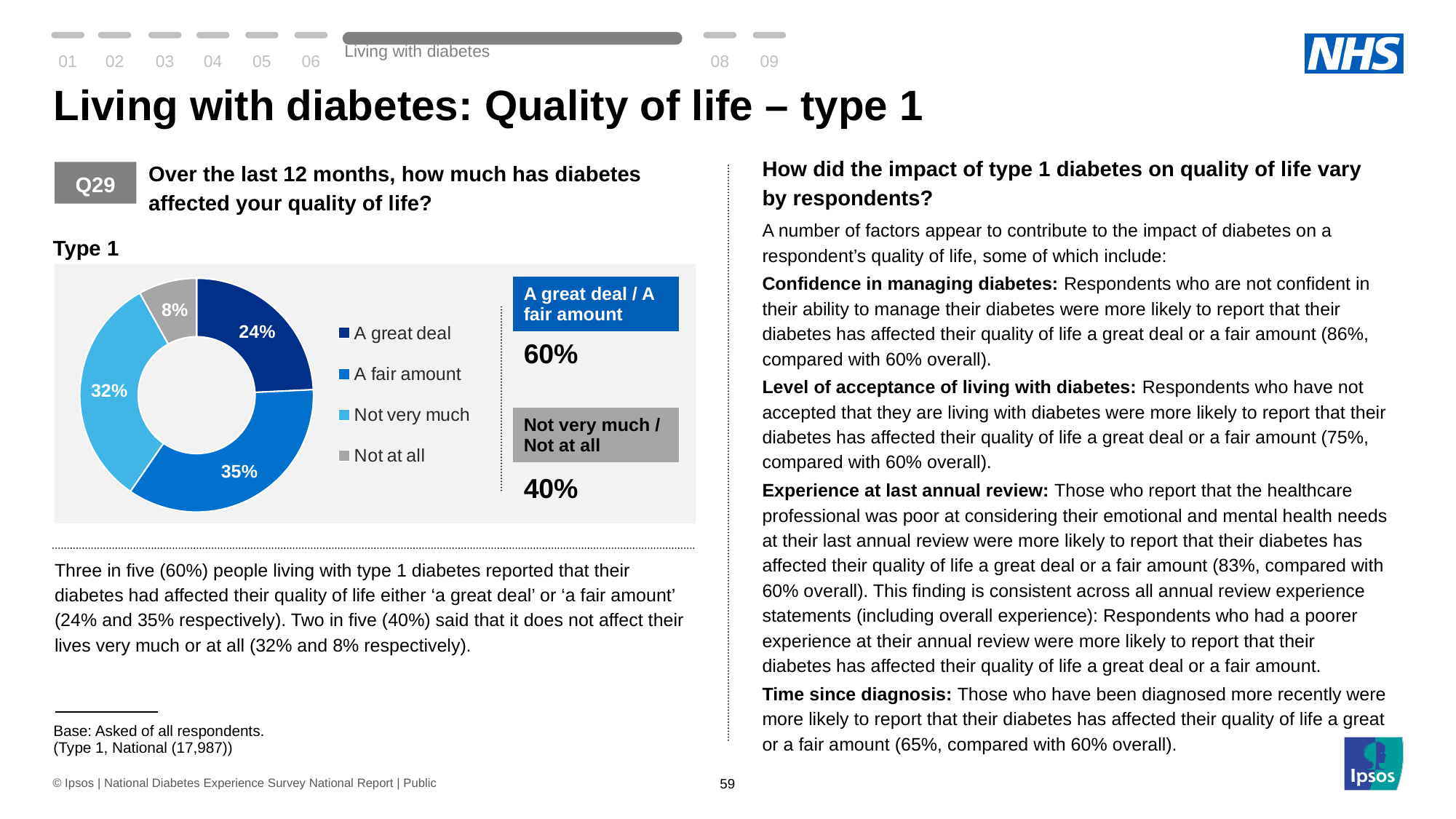
What percentage of type 1 respondents said diabetes affected their quality of life 'A fair amount'? 35% What percentage of type 1 respondents said diabetes affected their quality of life 'A great deal'? 24% What kind of chart is shown on the slide? Doughnut chart Which is larger, the share for 'Not very much' or the share for 'A great deal'? Not very much What is the combined percentage for 'A great deal' and 'A fair amount' shown beside the chart? 60% Which response category has the smallest share of the doughnut chart? Not at all What is the combined percentage for 'Not very much' and 'Not at all' shown beside the chart? 40% What percentage of type 1 respondents said diabetes affected their quality of life 'Not very much'? 32% How many response categories are shown in the doughnut chart? 4 What is the difference in percentage points between 'A fair amount' and 'A great deal'? 11 Which response category has the largest share of the doughnut chart? A fair amount What percentage of type 1 respondents said diabetes affected their quality of life 'Not at all'? 8%